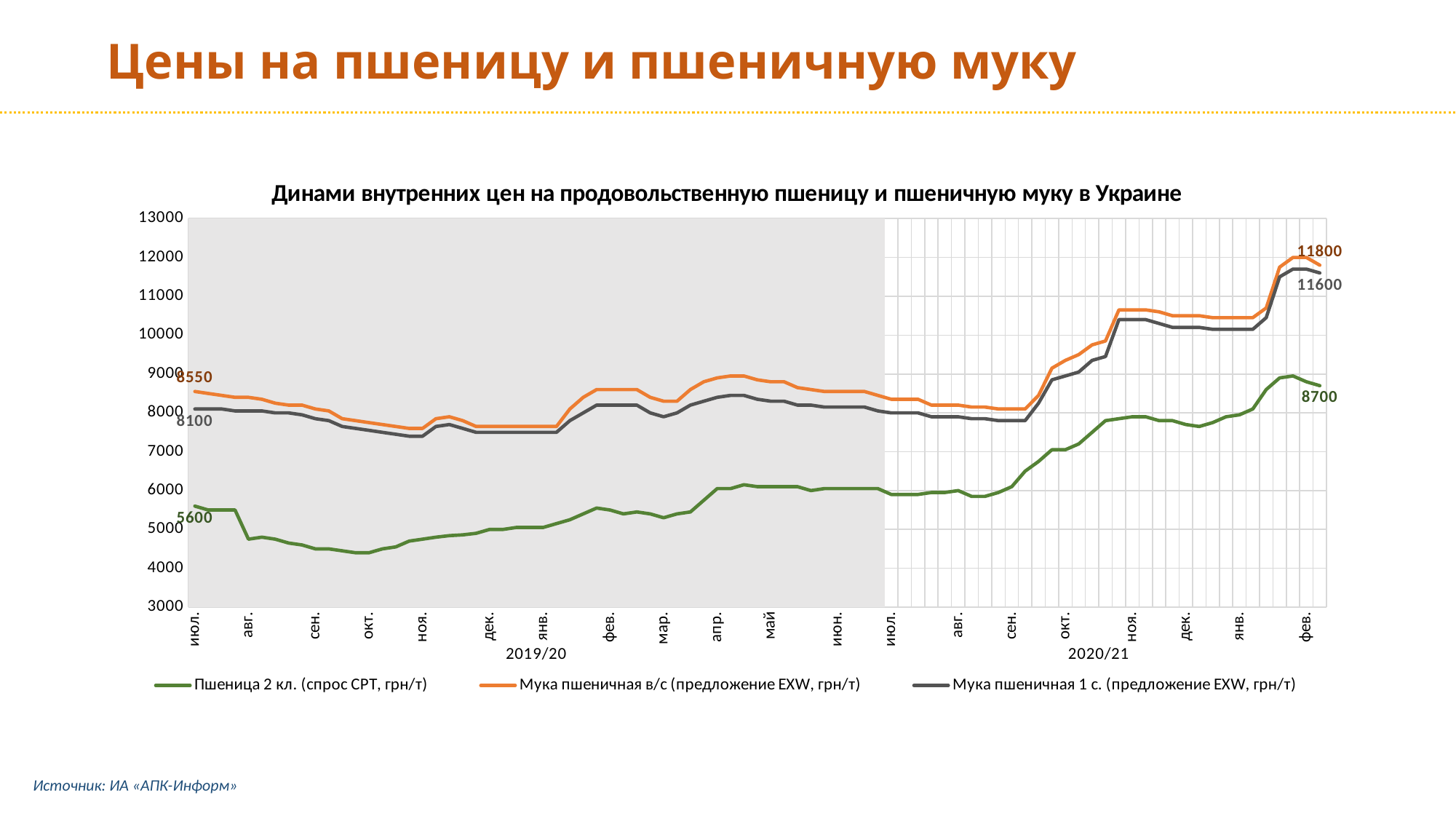
Does the series "Пшеница 2 кл. (спрос CPT, грн/т)" generally rise or fall from September 2020 to February 2021? rise What kind of chart is shown on the slide? line chart What is the first labelled value of the series "Мука пшеничная в/с (предложение EXW, грн/т)" in July 2019? 8550 What is the first labelled value of the series "Пшеница 2 кл. (спрос CPT, грн/т)" in July 2019? 5600 Is the value of "Пшеница 2 кл. (спрос CPT, грн/т)" in October 2019 greater or less than 5000? less How many series does the legend list? 3 What is the last labelled value of the series "Мука пшеничная в/с (предложение EXW, грн/т)" in February 2021? 11800 Which series has the higher last labelled value: "Мука пшеничная в/с" or "Мука пшеничная 1 с."? Мука пшеничная в/с What is the last labelled value of the series "Пшеница 2 кл. (спрос CPT, грн/т)" in February 2021? 8700 What is the difference between the last labelled values of "Мука пшеничная в/с" (11800) and "Мука пшеничная 1 с." (11600)? 200 By how much did the labelled value of "Пшеница 2 кл. (спрос CPT, грн/т)" change from its first label (5600) to its last label (8700)? 3100 What is the first labelled value of the series "Мука пшеничная 1 с. (предложение EXW, грн/т)" in July 2019? 8100